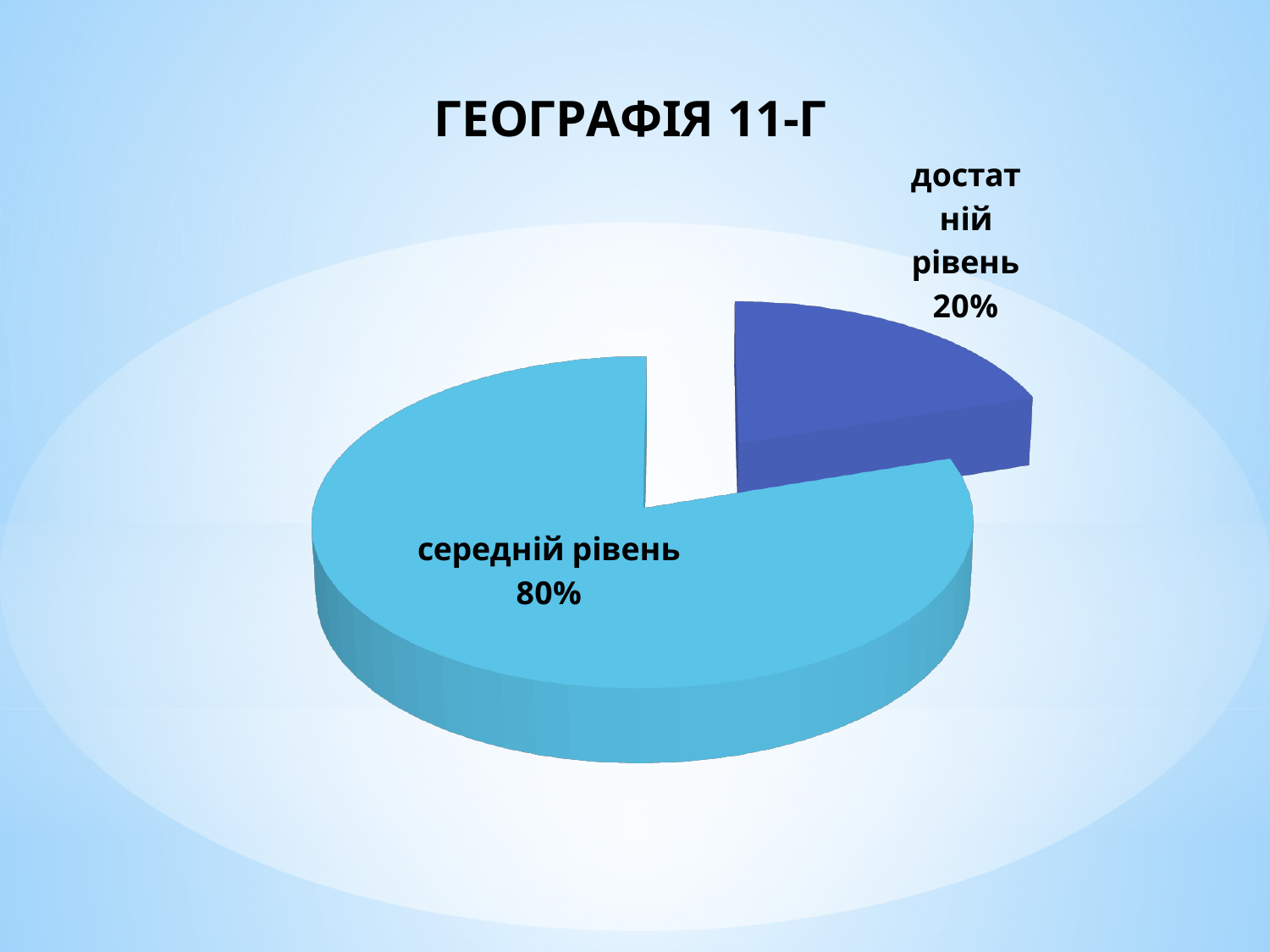
Which is larger, "середній рівень" or "достатній рівень"? середній рівень What share of the pie does "середній рівень" have? 80% What colour is the "достатній рівень" slice? dark blue What is the difference in percentage points between "середній рівень" and "достатній рівень"? 60 What is the title of the chart? ГЕОГРАФІЯ 11-Г Which slice is the largest? середній рівень Which slice is the smallest? достатній рівень What share of the pie does "достатній рівень" have? 20% What kind of chart is shown on the slide? pie chart How many slices does the pie chart have? 2